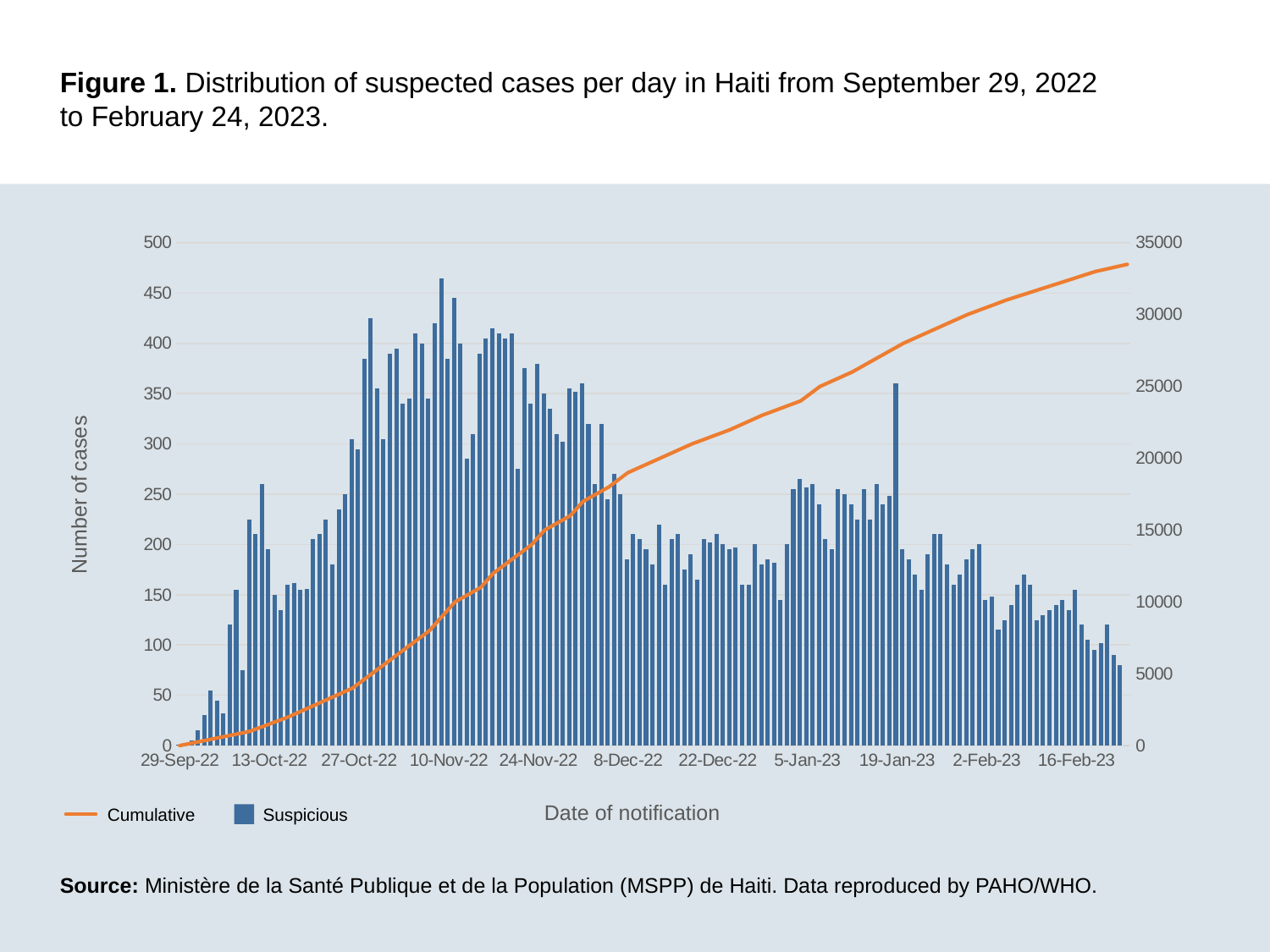
How many series does the legend list? 2 Is the Cumulative value at 8-Dec-22 greater or less than 15000? greater What are the two series named in the legend? Cumulative and Suspicious Is the Suspicious value on 29-Sep-22 greater or less than 50? less Is the Cumulative value at 16-Feb-23 greater or less than 30000? greater Which series is drawn as an orange line? Cumulative Does the Cumulative line rise or fall from 29-Sep-22 to 16-Feb-23? Rises What kind of chart is shown on the slide? A bar chart combined with a line Do the Suspicious bars generally rise or fall from 24-Nov-22 to 16-Feb-23? Fall